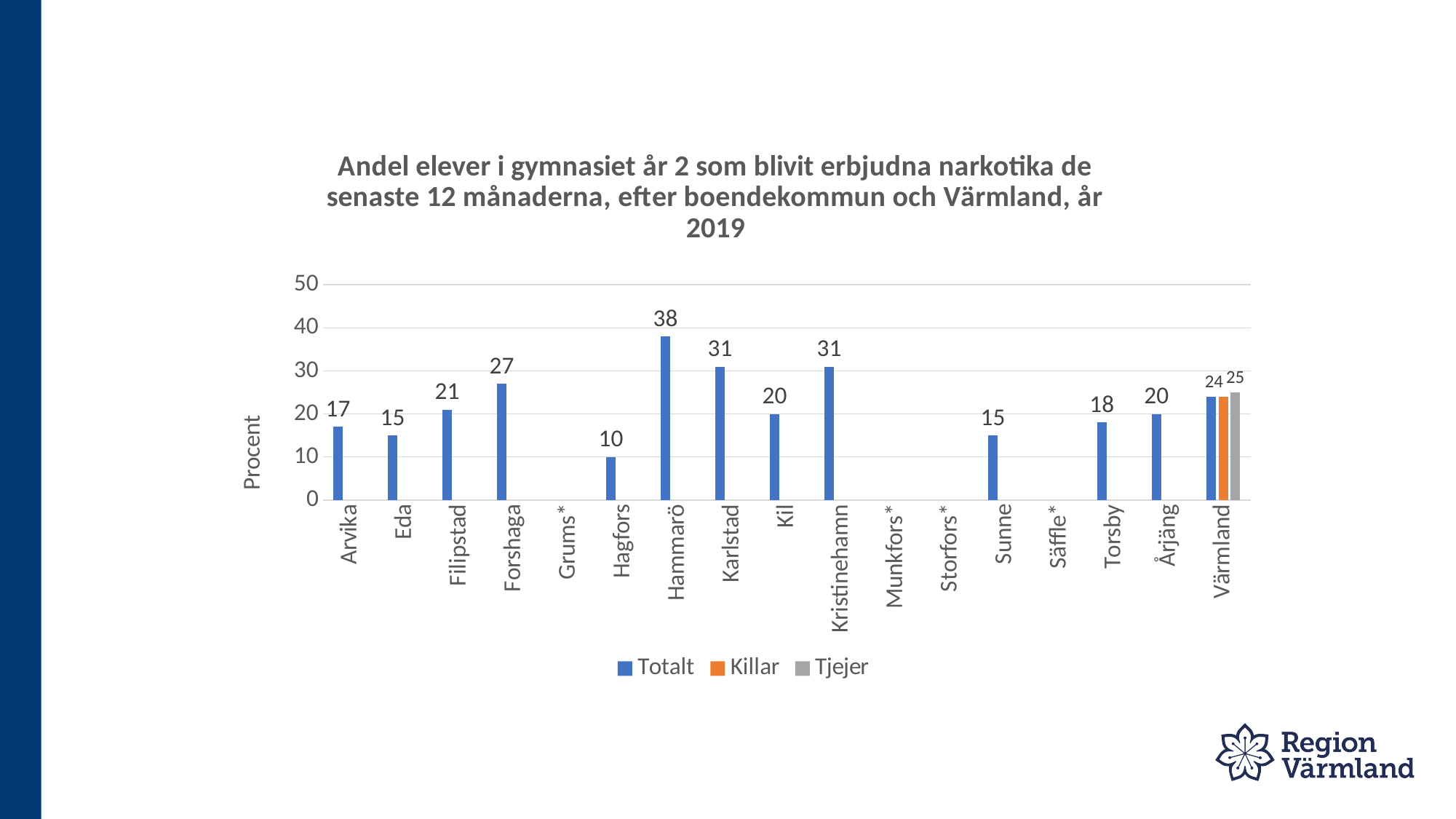
What is the Tjejer value for Värmland? 25 What is the Totalt value for Hammarö? 38 How many categories are labelled on the x axis? 17 Which has a higher Totalt value, Karlstad or Kil? Karlstad What is the difference between the Totalt values for Forshaga and Filipstad? 6 How many series does the legend list? 3 What is the label on the y axis? Procent What kind of chart is shown on the slide? Bar chart What is the Totalt value for Torsby? 18 Among the municipalities with a plotted bar, which has the lowest Totalt value? Hagfors What is the Totalt value for Värmland? 24 Which municipality has the highest Totalt value? Hammarö